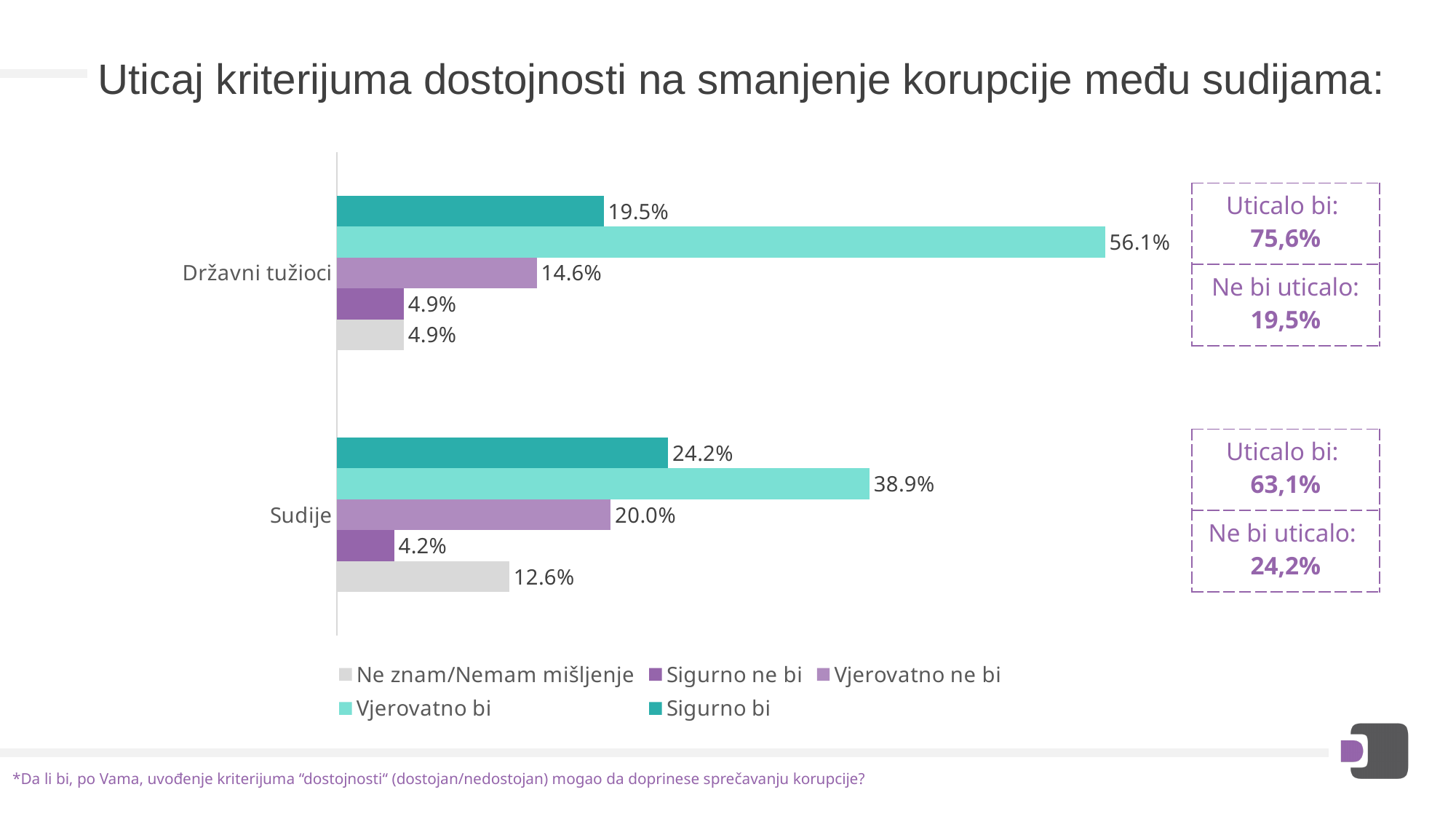
What kind of chart is shown on the slide? Bar chart Which series has the lowest value for Sudije? Sigurno ne bi What is the value for "Ne znam/Nemam mišljenje" for Sudije? 12.6% Which category has the larger value for "Ne znam/Nemam mišljenje", Državni tužioci or Sudije? Sudije How many categories are shown on the chart? 2 Which category has the larger value for "Sigurno bi", Državni tužioci or Sudije? Sudije How many series does the legend list? 5 Which series has the highest value for Sudije? Vjerovatno bi What is the difference between the "Vjerovatno bi" values for Državni tužioci and Sudije? 17.2% What is the value for "Vjerovatno bi" for Državni tužioci? 56.1% What is the value for "Vjerovatno ne bi" for Državni tužioci? 14.6% What is the value for "Sigurno bi" for Sudije? 24.2%